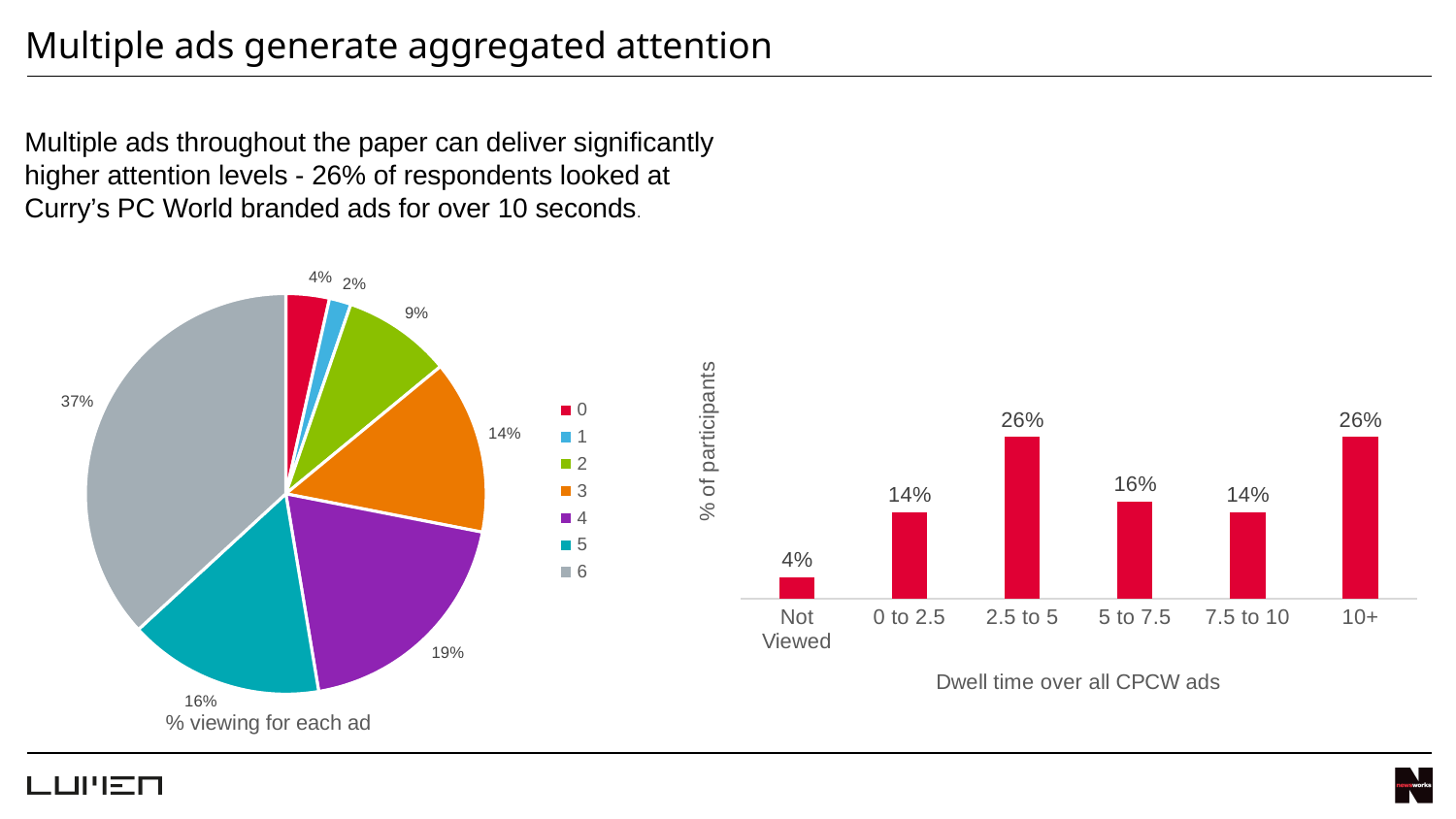
In the pie chart on the left, what share is labelled for category 6? 37% In the bar chart on the right, what is the value for '5 to 7.5'? 16% What kind of chart is the chart on the right of the slide? Bar chart In the pie chart on the left, which category has the smallest slice? 1 In the pie chart on the left, which category has the largest slice? 6 In the pie chart on the left, how many categories does the legend list? 7 In the bar chart on the right, what is the value for 'Not Viewed'? 4% In the pie chart on the left, what is the difference between the shares for category 4 and category 5? 3% In the pie chart on the left, what share is labelled for category 1? 2% In the bar chart on the right, which is larger, the value for '5 to 7.5' or the value for '7.5 to 10'? 5 to 7.5 In the bar chart on the right, how many categories are shown on the x axis? 6 In the bar chart on the right, what is the difference between the values for '2.5 to 5' and '0 to 2.5'? 12%